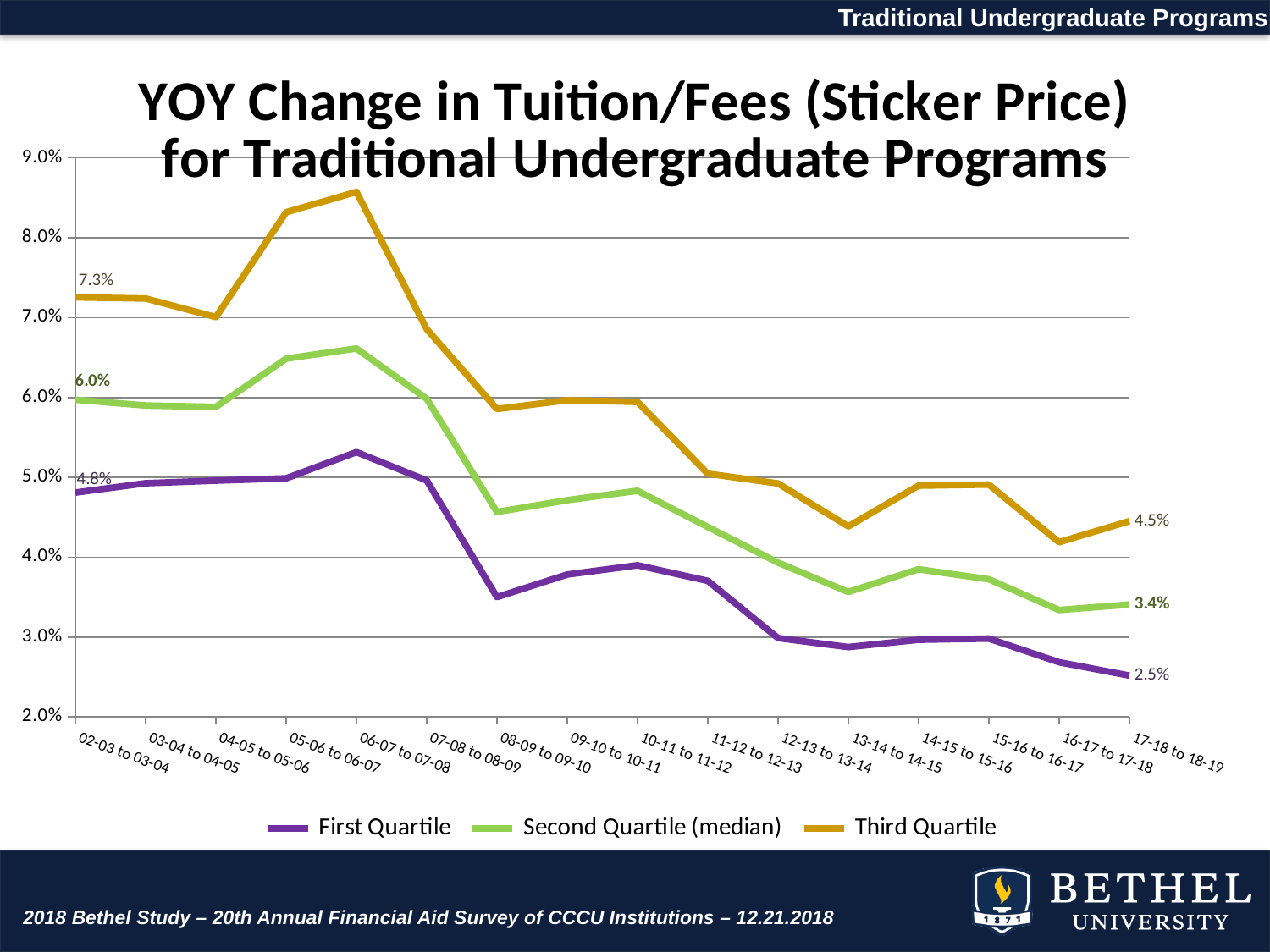
Is the Third Quartile value for 06-07 to 07-08 greater or less than 8.0%? greater What is the First Quartile value for 02-03 to 03-04? 4.8% What is the First Quartile value for 17-18 to 18-19? 2.5% By how many percentage points did the Third Quartile value fall from 02-03 to 03-04 to 17-18 to 18-19? 2.8 percentage points How many series does the legend list? 3 In which period does the Third Quartile line reach its highest value? 06-07 to 07-08 How many year-over-year periods are shown on the x axis? 16 What kind of chart is shown on the slide? Line chart By how many percentage points did the First Quartile value fall from 02-03 to 03-04 to 17-18 to 18-19? 2.3 percentage points Does the First Quartile line generally rise or fall across the periods shown? Fall What is the Second Quartile (median) value for 17-18 to 18-19? 3.4% What is the Third Quartile value for 02-03 to 03-04? 7.3%